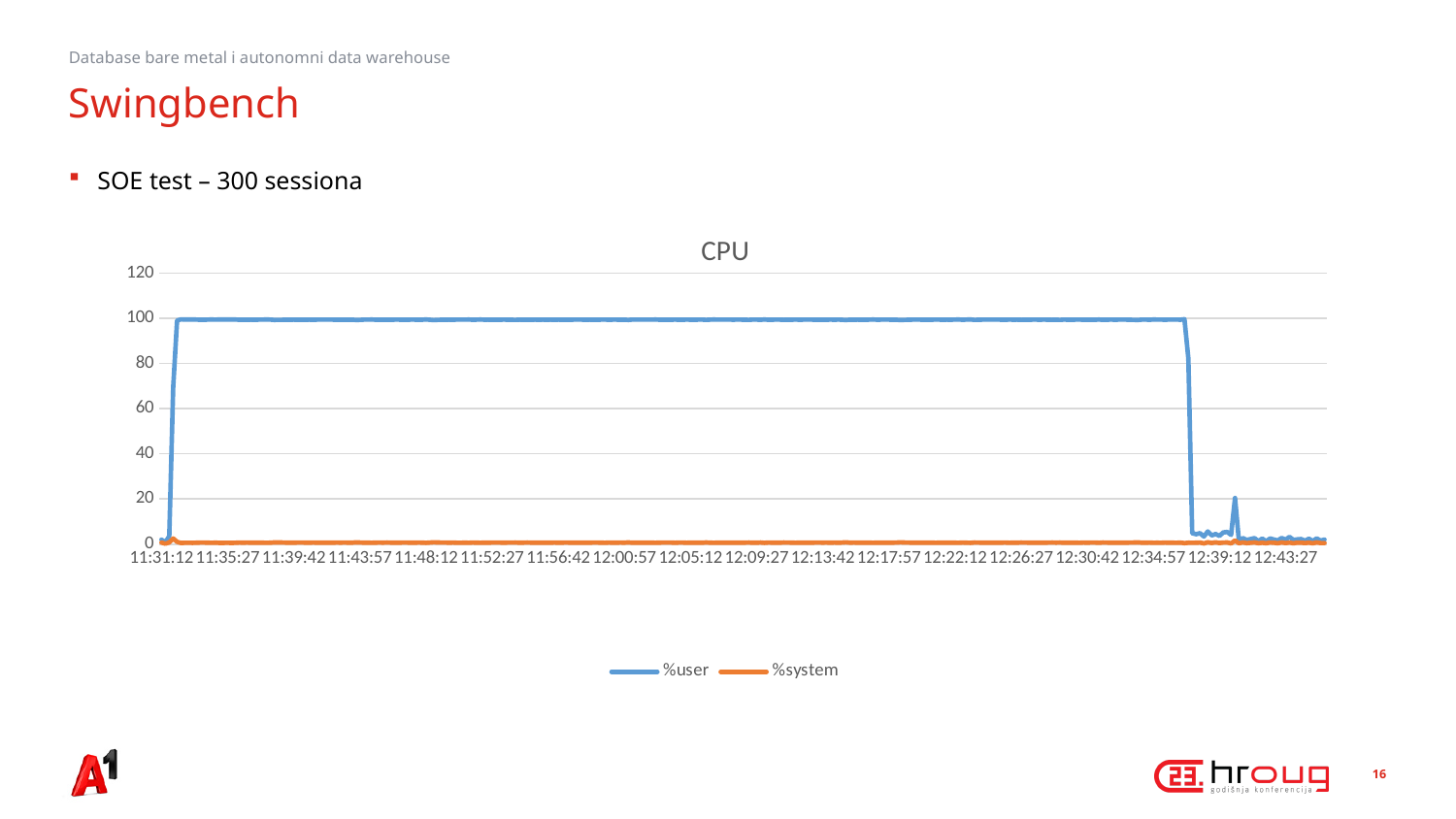
What is the title of the chart? CPU Does the %user line rise or fall between 11:31:12 and 11:35:27? rise Is the value for %user at 12:05:12 greater or less than 80? greater Does the %user line rise or fall between 12:34:57 and 12:39:12? fall What kind of chart is shown on the slide? line chart Is the value for %system at 12:05:12 greater or less than 20? less How many time labels are shown on the x axis of the CPU chart? 18 How many series does the legend of the CPU chart list? 2 Is the value for %user at 12:43:27 greater or less than 20? less Which series has the larger value at 12:00:57, %user or %system? %user Which series is drawn in blue in the CPU chart? %user